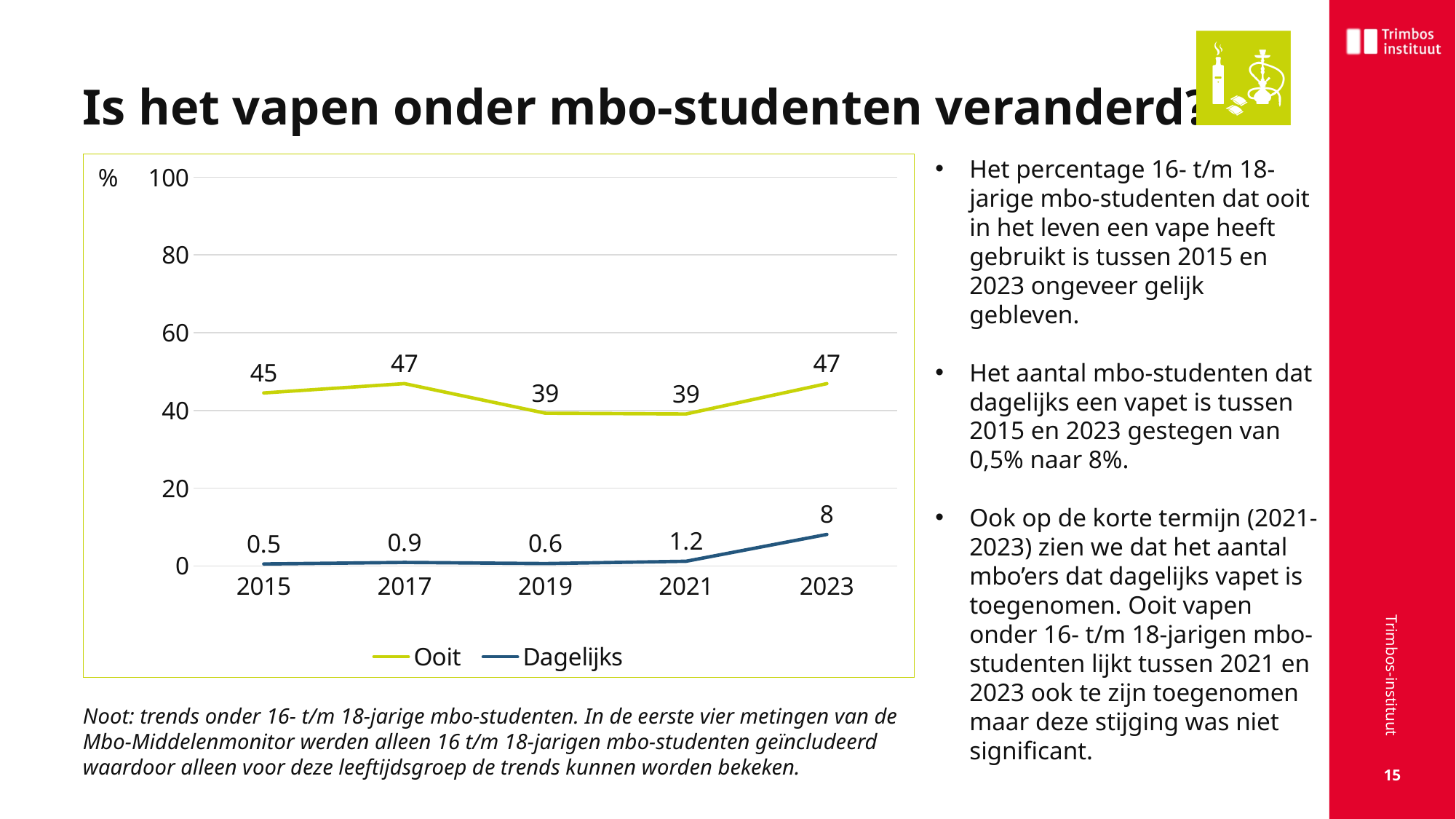
Is the Ooit value for 2021 greater or less than 60? less What kind of chart is shown on the slide? line chart What is the value for the Dagelijks series in 2023? 8 What is the value for the Dagelijks series in 2021? 1.2 In which year is the Dagelijks series highest? 2023 Which is larger: the Ooit value in 2015 or the Ooit value in 2023? 2023 What is the difference between the Ooit values for 2017 and 2019? 8 What is the value for the Ooit series in 2015? 45 How many series does the legend list? 2 Does the Dagelijks series rise or fall between 2021 and 2023? rise How many years are shown on the x axis? 5 In which year is the Dagelijks series lowest? 2015